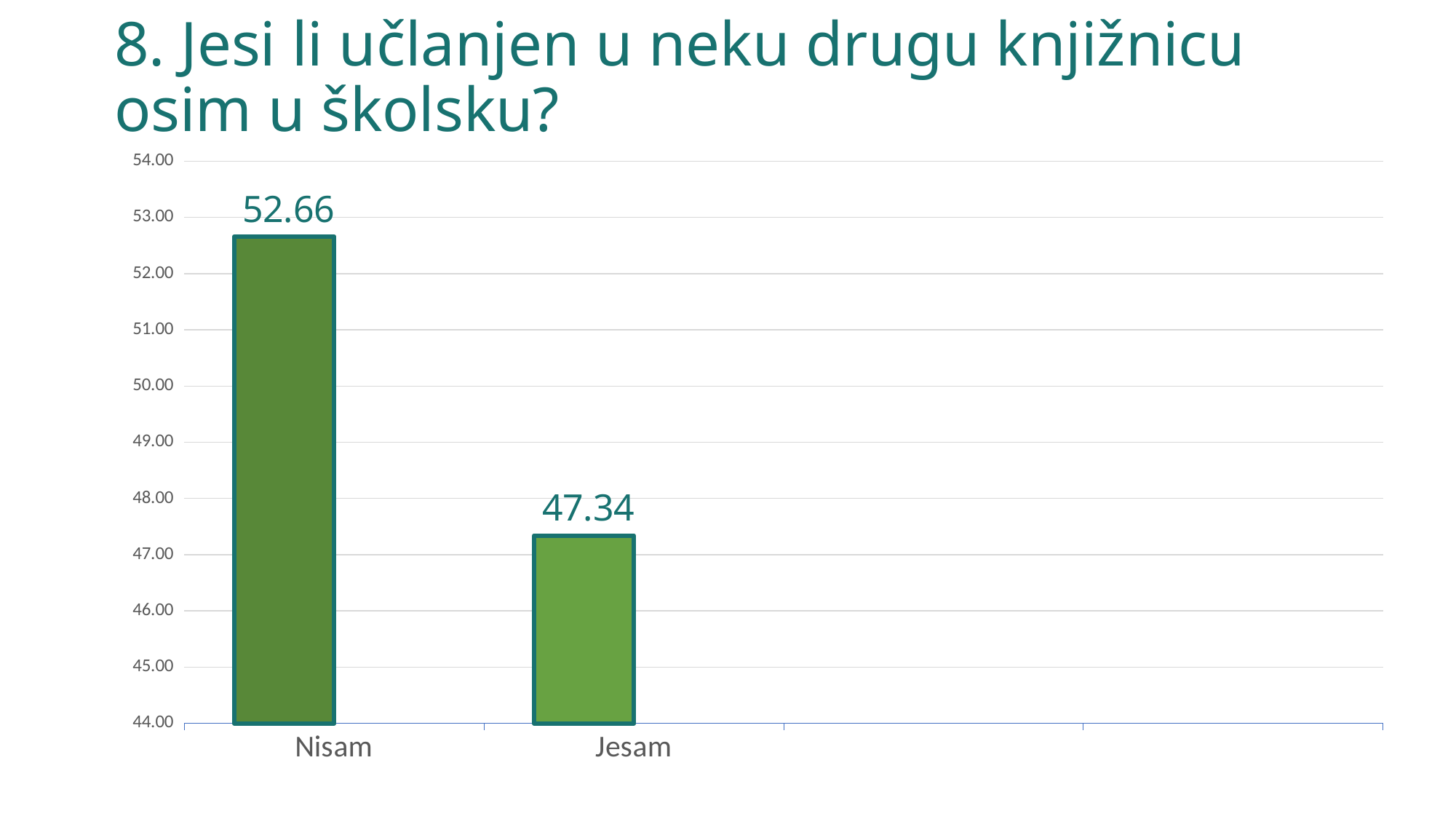
Which is larger, the value for Nisam or the value for Jesam? Nisam Is the value for Nisam greater or less than 52.00? greater Is the value for Jesam greater or less than 48.00? less What is the value for Nisam? 52.66 What is the difference between the values for Nisam and Jesam? 5.32 Which category has the highest value? Nisam Which category has the lowest value? Jesam How many categories are shown on the chart? 2 What is the title of the slide? 8. Jesi li učlanjen u neku drugu knjižnicu osim u školsku? What is the value for Jesam? 47.34 What kind of chart is shown on the slide? bar chart What is the lowest value shown on the vertical axis? 44.00